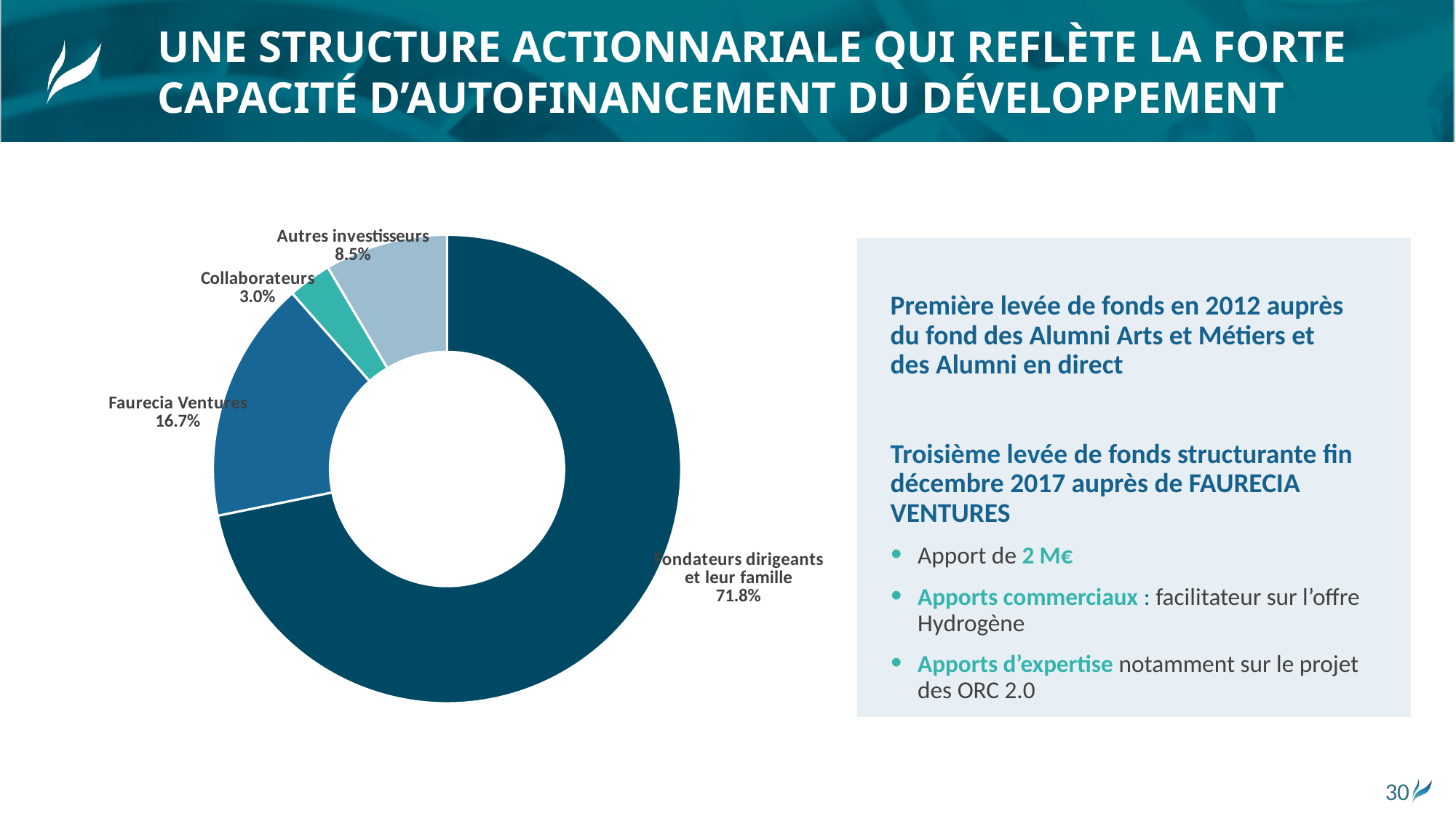
Which category holds the smallest share of the shareholding? Collaborateurs Which category holds the largest share of the shareholding? Fondateurs dirigeants et leur famille What kind of chart is shown on the slide? Pie chart (doughnut) How many categories are shown in the chart? 4 What is the combined share of Faurecia Ventures and Collaborateurs? 19.7% What share of the shareholding is held by Autres investisseurs? 8.5% What share of the shareholding is held by Fondateurs dirigeants et leur famille? 71.8% Which holds a larger share: Autres investisseurs or Collaborateurs? Autres investisseurs Which category is shown in the light grey-blue colour? Autres investisseurs What share of the shareholding is held by Faurecia Ventures? 16.7% What share of the shareholding is held by Collaborateurs? 3.0% What is the difference in percentage points between the Faurecia Ventures share and the Autres investisseurs share? 8.2